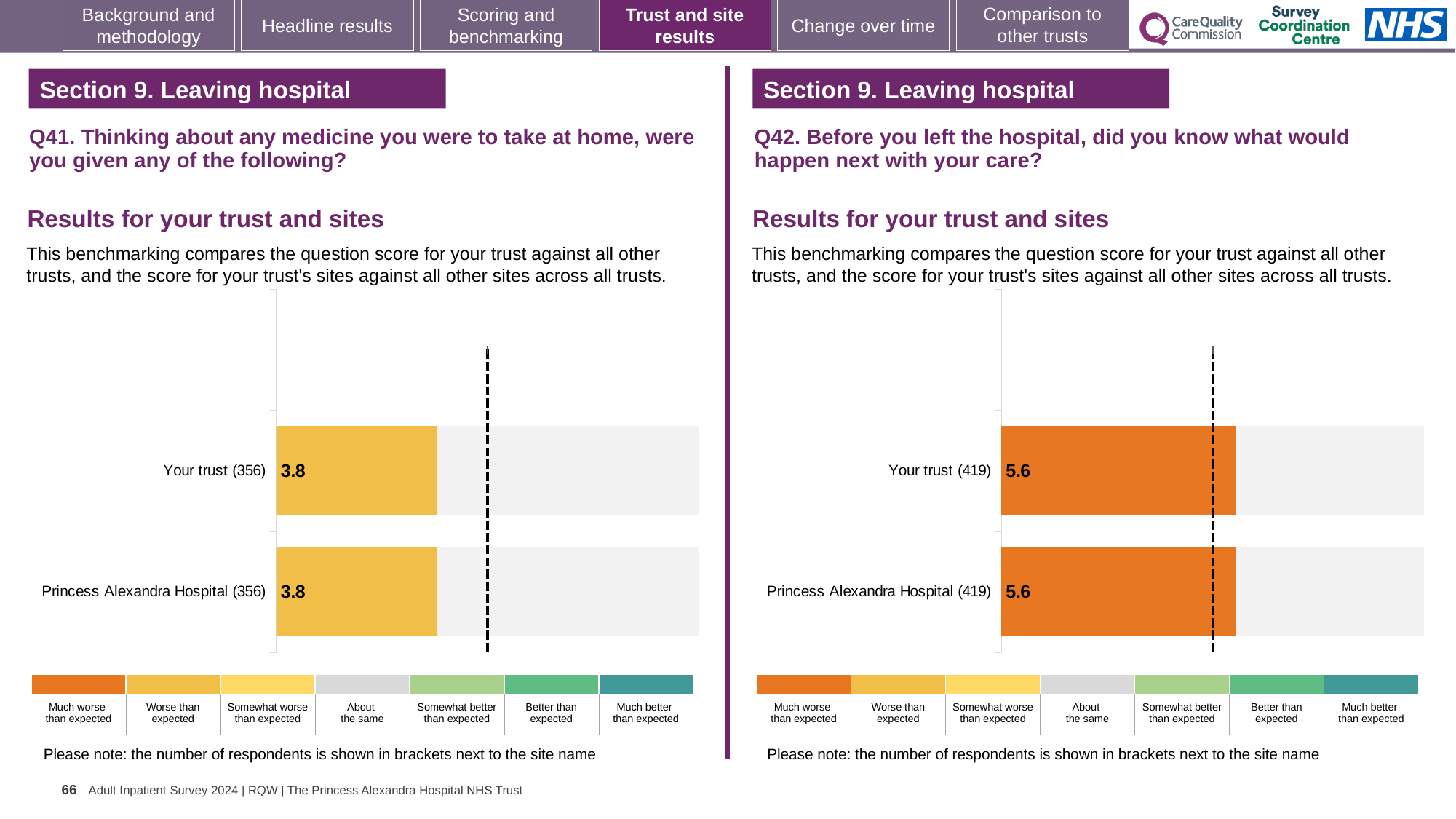
How many bars are plotted on the Q42 chart (right)? 2 On the Q42 chart (right), what is the score for Your trust? 5.6 On the Q42 chart (right), what is the score for Princess Alexandra Hospital? 5.6 On the Q41 chart (left), what is the score for Princess Alexandra Hospital? 3.8 On the Q42 chart (right), what is the difference between the score for Your trust and the score for Princess Alexandra Hospital? 0 On the Q41 chart (left), what is the difference between the score for Your trust and the score for Princess Alexandra Hospital? 0 On the Q42 chart (right), how many respondents are shown in brackets for Princess Alexandra Hospital? 419 On the Q41 chart (left), what is the score for Your trust? 3.8 On the Q42 chart (right), which benchmark category does the bar colour for Your trust correspond to in the colour key? Much worse than expected How many bars are plotted on the Q41 chart (left)? 2 What kind of chart is the Q41 chart (left)? Bar chart On the Q41 chart (left), how many respondents are shown in brackets for Your trust? 356